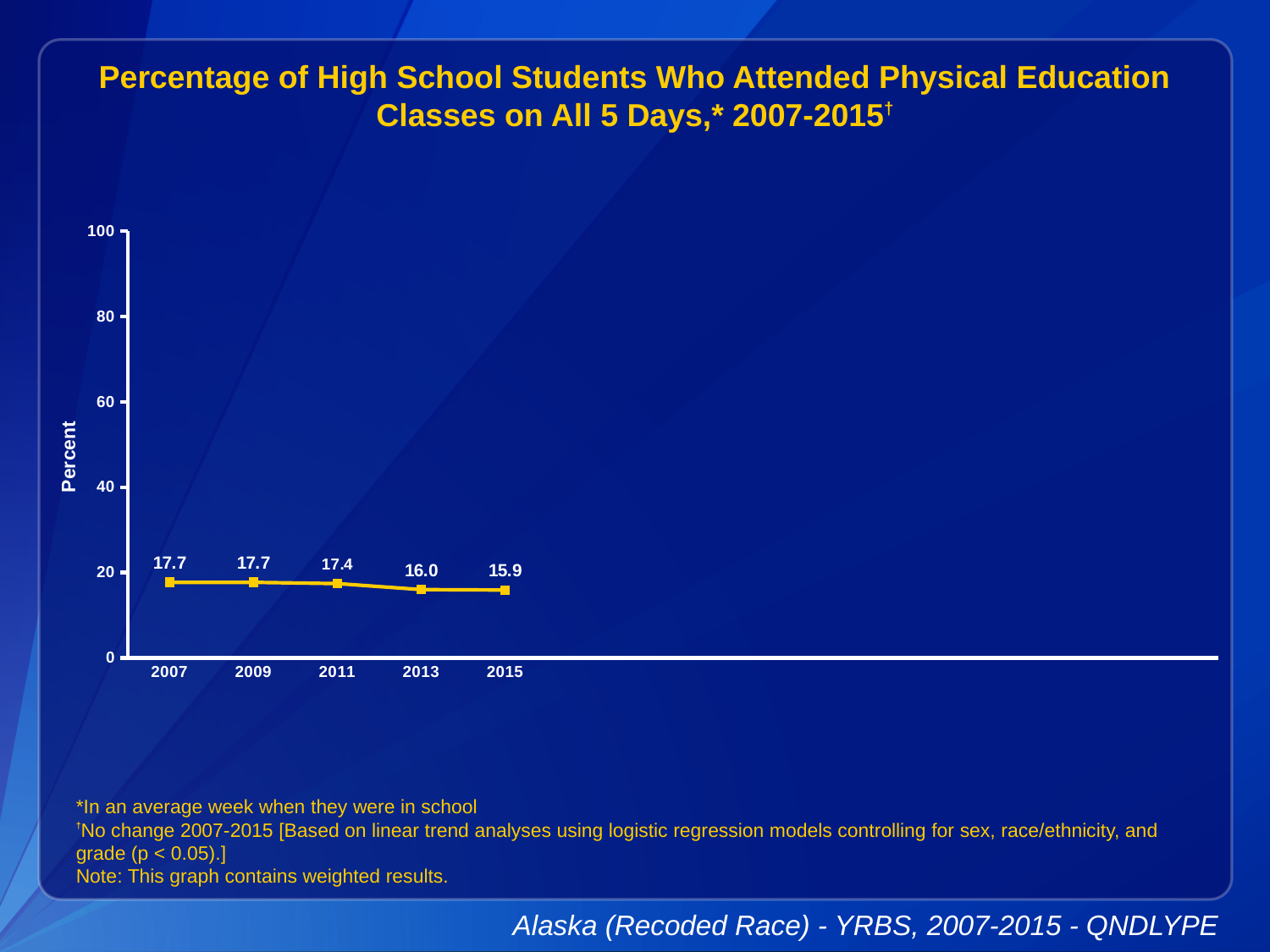
What is the value for 2013? 16.0 What kind of chart is shown? line chart Which year has the lowest value? 2015 What is the value for 2011? 17.4 What is the value for 2015? 15.9 Which is larger, the value for 2009 or the value for 2013? 2009 What is the difference between the values for 2007 and 2015? 1.8 What is the value for 2007? 17.7 Do the values rise or fall from 2007 to 2015? fall What is the difference between the values for 2011 and 2013? 1.4 How many years are plotted on the chart? 5 Is the value for 2007 greater or less than 20? less